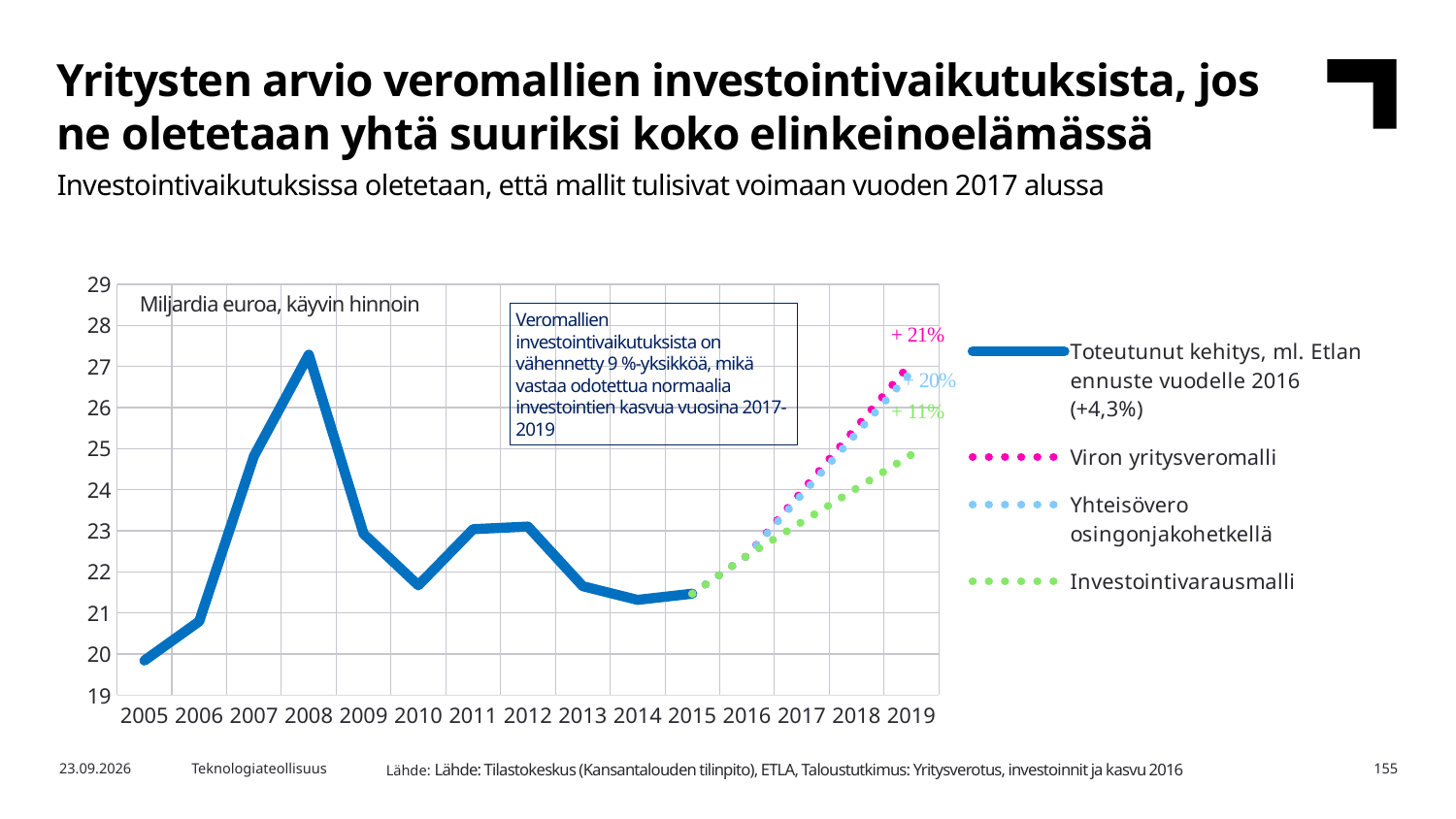
What percentage growth label is shown for the Viron yritysveromalli series in 2019? + 21% How many series does the legend list? 4 Is the Toteutunut kehitys value for 2008 greater or less than 27? greater Is the Toteutunut kehitys value for 2014 greater or less than 22? less Which is larger, the Toteutunut kehitys value for 2008 or for 2012? 2008 Does the Toteutunut kehitys line rise or fall from 2005 to 2008? rise How many years are shown on the x axis? 15 In which year is the Toteutunut kehitys line at its lowest value? 2005 What kind of chart is shown on the slide? line chart Is the Viron yritysveromalli value for 2019 greater or less than 26? greater In which year does the Toteutunut kehitys line reach its highest value? 2008